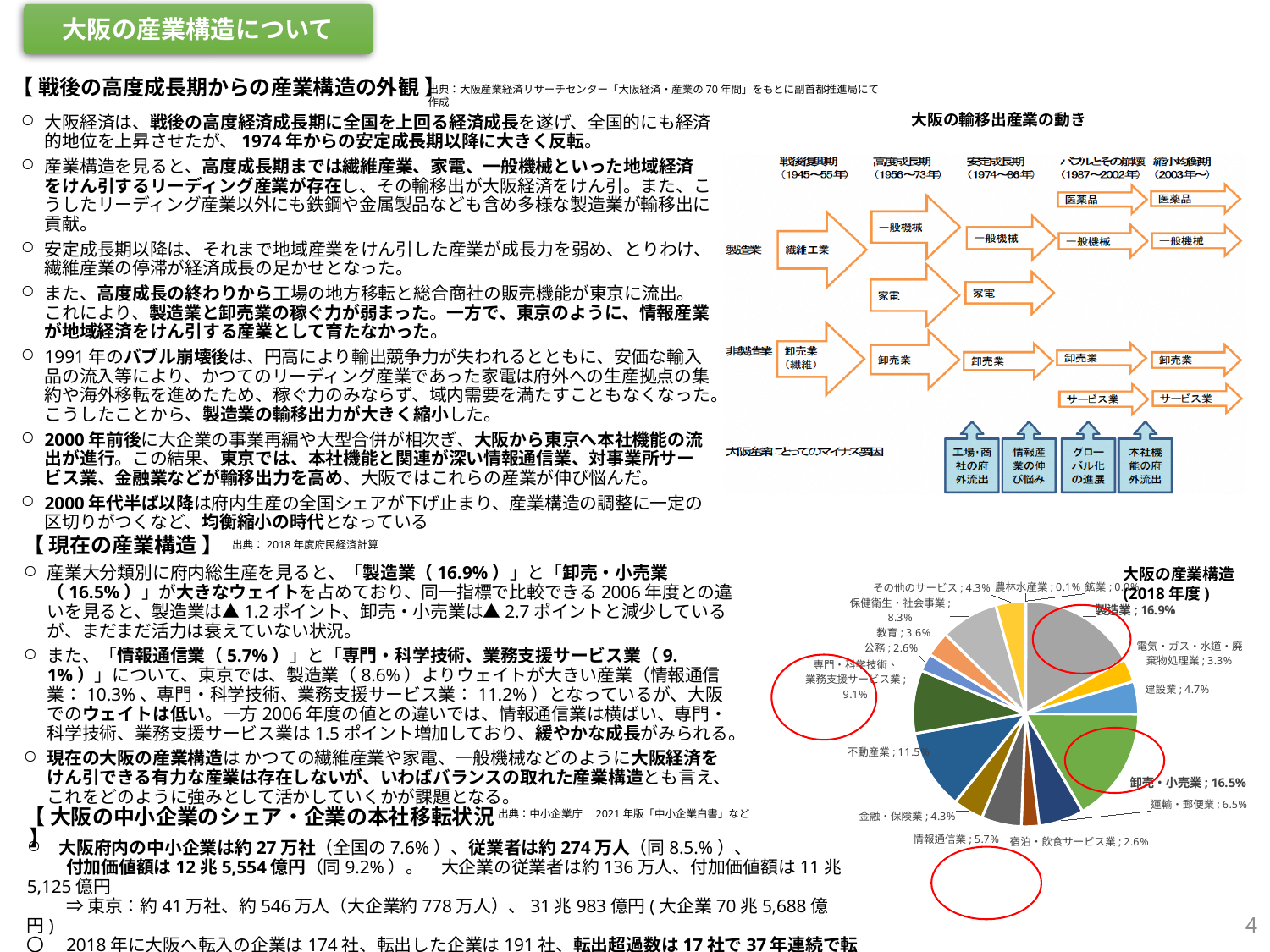
In the 大阪の産業構造（2018年度） pie chart, what share does 不動産業 have? 11.5% In the 大阪の産業構造（2018年度） pie chart, what share does 卸売・小売業 have? 16.5% In the 大阪の産業構造（2018年度） pie chart, which industry has the smallest share? 鉱業 In the 大阪の産業構造（2018年度） pie chart, which has the larger share, 不動産業 or 運輸・郵便業? 不動産業 How many industry categories are shown in the 大阪の産業構造（2018年度） pie chart? 16 In the 大阪の産業構造（2018年度） pie chart, what share does 製造業 have? 16.9% In the 大阪の産業構造（2018年度） pie chart, which industry has the largest share? 製造業 In the 大阪の産業構造（2018年度） pie chart, what share does 情報通信業 have? 5.7% In the 大阪の産業構造（2018年度） pie chart, what is the difference in percentage points between 製造業 and 卸売・小売業? 0.4 percentage points What is the title of the pie chart on the slide? 大阪の産業構造（2018年度） In the 大阪の産業構造（2018年度） pie chart, what share does 専門・科学技術、業務支援サービス業 have? 9.1% What kind of chart is the 大阪の産業構造（2018年度） chart? pie chart